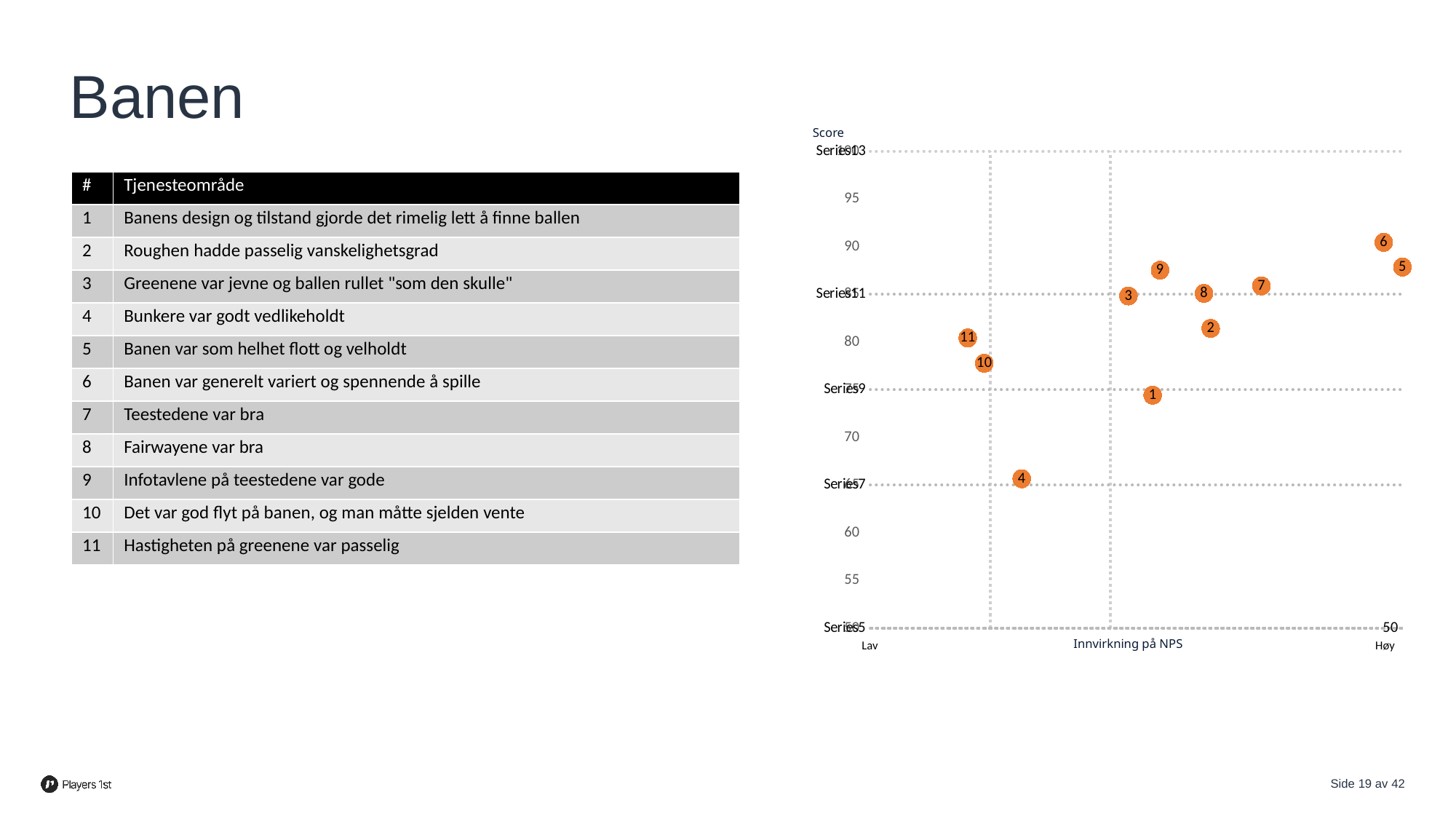
Which numbered point has the lowest score in the chart? 4 What is the title of the vertical axis in the chart? Score How many numbered points are plotted in the chart? 11 Is the score for point 6 greater or less than 85? greater What kind of chart is shown on the slide? scatter chart Is the score for point 3 greater or less than 80? greater What is the title of the horizontal axis in the chart? Innvirkning på NPS Is the score for point 1 greater or less than 80? less Which numbered point has the highest score in the chart? 6 Which has the higher score, point 3 or point 10? point 3 Which has the higher score, point 9 or point 1? point 9